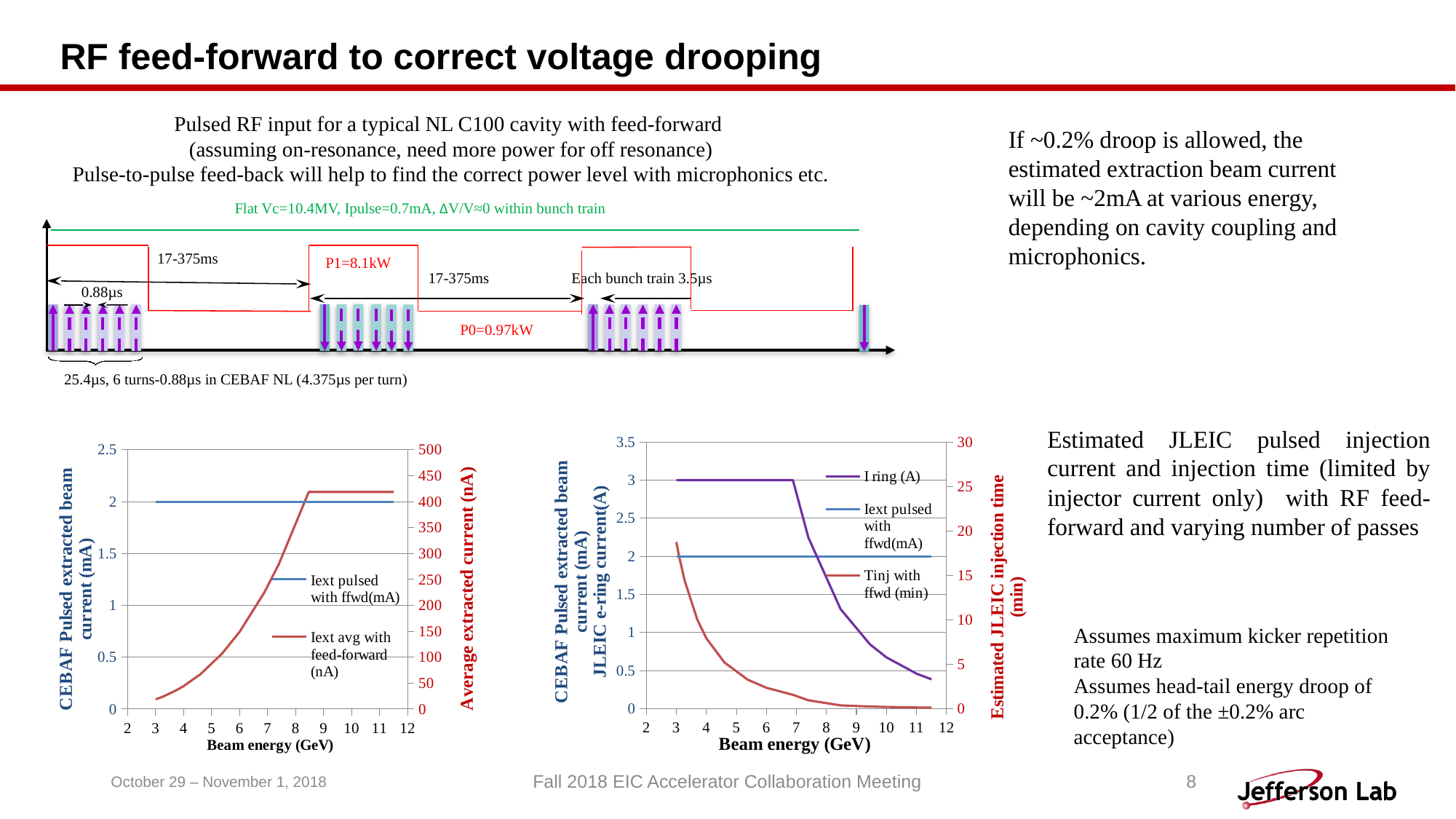
In the left chart, is the value of Iext avg with feed-forward (nA) at 7 GeV greater or less than 200? greater In the right chart, does I ring (A) rise or fall as beam energy increases from 7 to 11 GeV? fall In the left chart, does Iext avg with feed-forward (nA) rise or fall as beam energy increases from 3 to 8 GeV? rise In the right chart, what is the value of Iext pulsed with ffwd(mA) at 8 GeV? 2 In the right chart, what is the value of I ring (A) at 5 GeV? 3 How many series does the legend of the right chart list? 3 What kind of chart is the left chart (CEBAF Pulsed extracted beam current vs Beam energy)? line chart What is the title of the right-hand vertical axis of the right chart? Estimated JLEIC injection time (min) In the left chart, what is the value of Iext pulsed with ffwd(mA) at 6 GeV? 2 How many series does the legend of the left chart list? 2 In the right chart, does Tinj with ffwd (min) rise or fall as beam energy increases? fall In the right chart, is the value of Tinj with ffwd (min) at 3 GeV greater or less than 15? greater